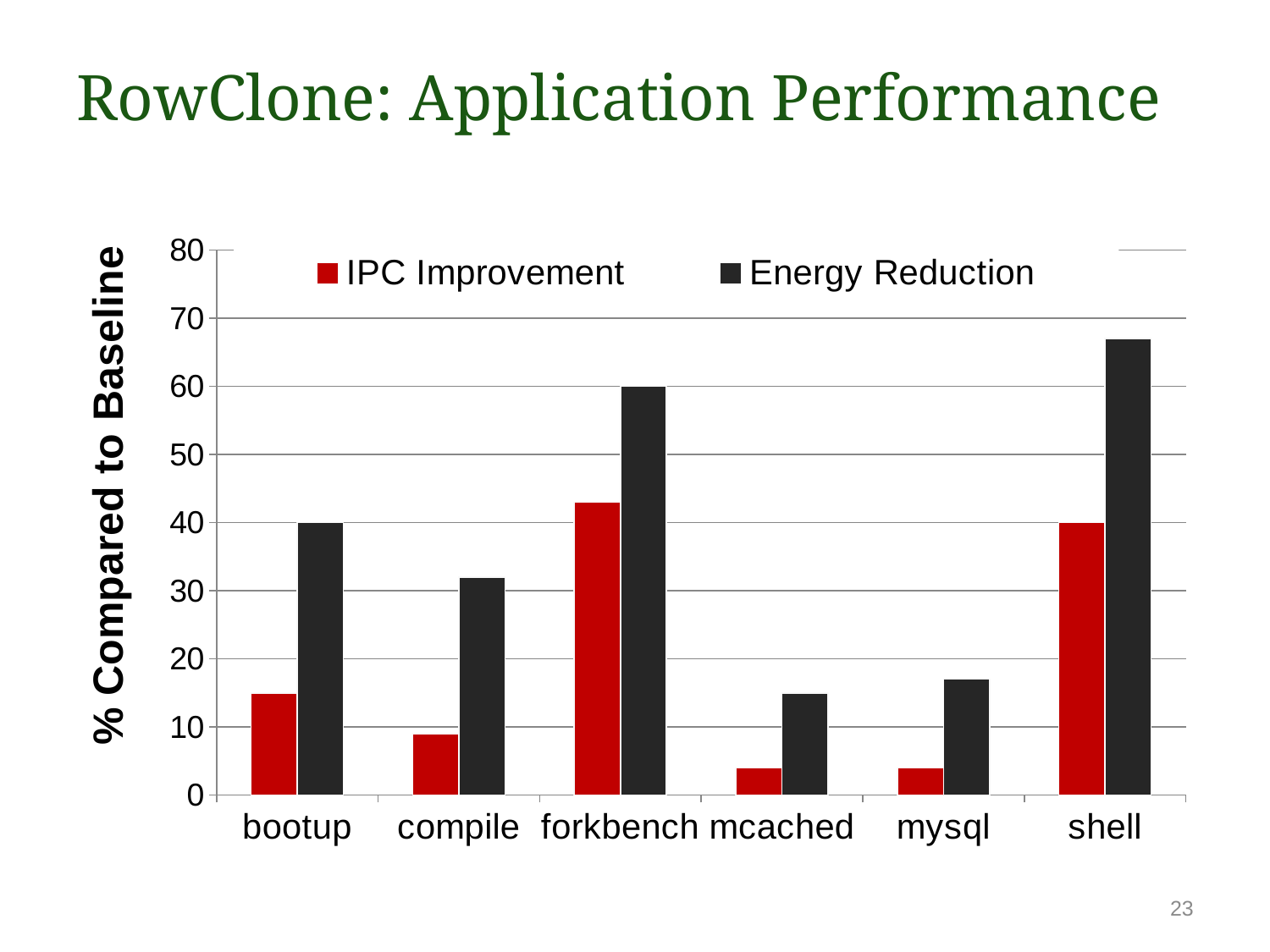
Is the Energy Reduction for forkbench greater or less than 50? greater Which is larger, the Energy Reduction for compile or for bootup? bootup How many applications are shown along the x axis? 6 Which is larger, the IPC Improvement for bootup or for compile? bootup Which application has the highest IPC Improvement? forkbench Which application has the highest Energy Reduction? shell What kind of chart is shown on the slide? bar chart How many series does the legend list? 2 What is the label on the y axis? % Compared to Baseline Is the IPC Improvement for mcached greater or less than 10? less Is the Energy Reduction for shell greater or less than 60? greater